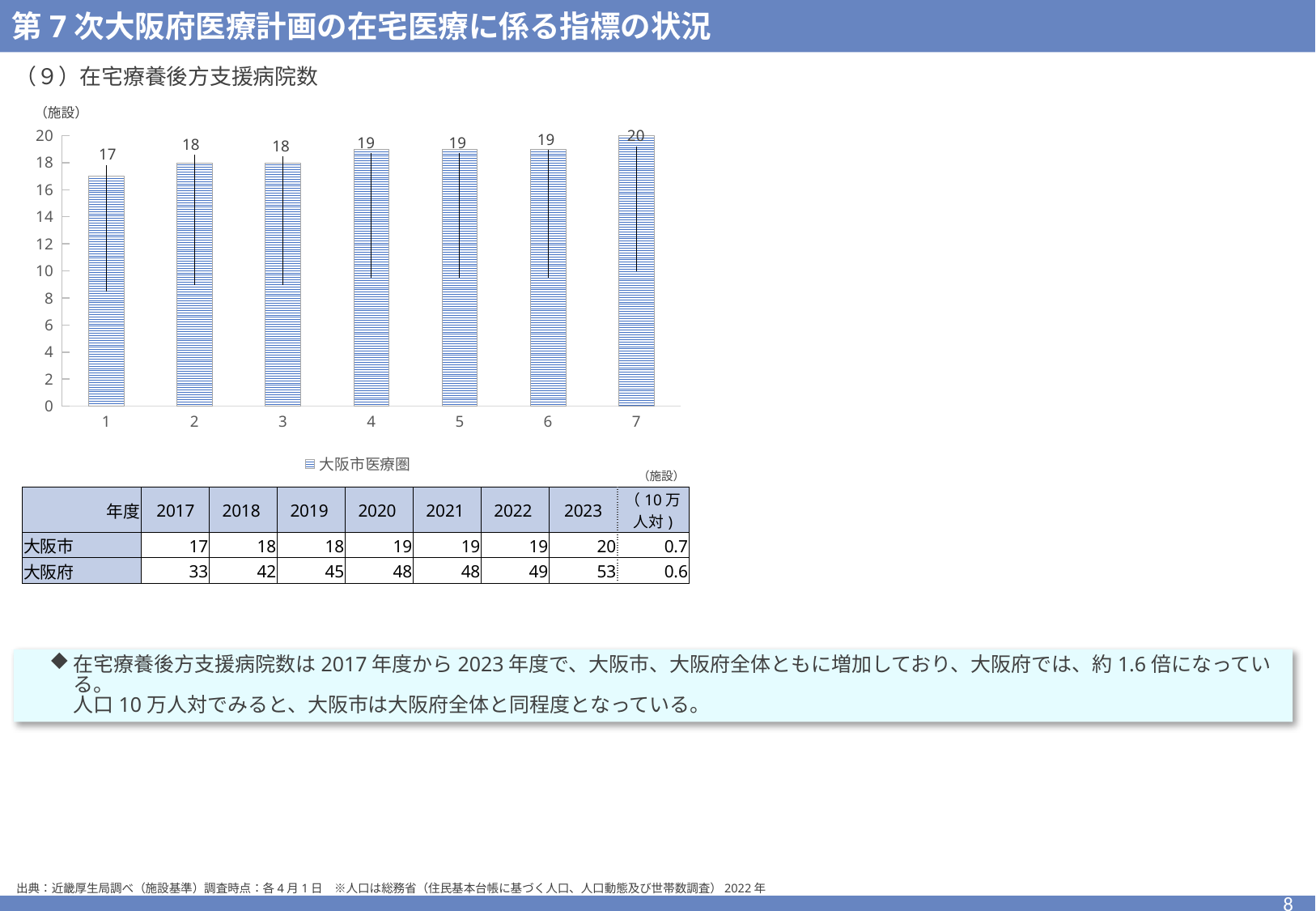
Which category has the lowest value in the bar chart? 1 What kind of chart is shown on the slide? bar chart How many series does the chart legend list? 1 Which category has the highest value in the bar chart? 7 Is the value for category 3 greater or less than 10? greater Which is larger, the value for category 2 or the value for category 4? category 4 How many bars are plotted in the chart? 7 What is the value for category 7 in the bar chart? 20 What is the difference between the values for category 7 and category 1? 3 What is the value for category 1 in the bar chart? 17 What is the value for category 4 in the bar chart? 19 What is the name of the series shown in the chart legend? 大阪市医療圏